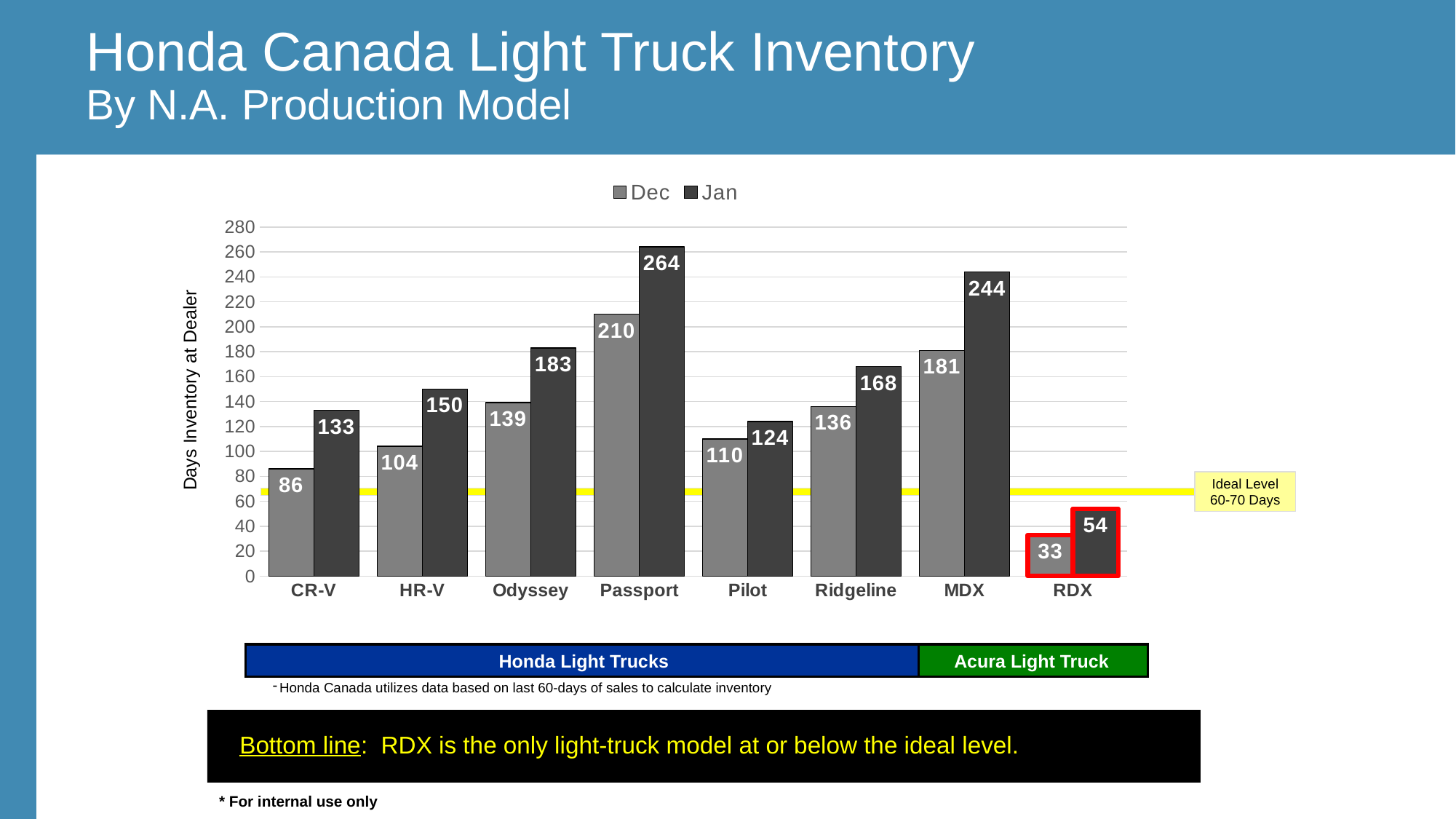
What kind of chart is shown on the slide? bar chart What is the difference between the Jan and Dec values for MDX? 63 Which model has the highest Jan days inventory? Passport Which is larger, the Jan value for Odyssey or the Jan value for Ridgeline? Odyssey How many series does the legend list? 2 What is the Jan days inventory value for Passport? 264 How many models are shown on the x axis? 8 Which model has the lowest Dec days inventory? RDX What is the label of the y axis? Days Inventory at Dealer What is the Dec days inventory value for CR-V? 86 What is the Dec value for RDX? 33 Is the Jan value for RDX greater or less than 60? less